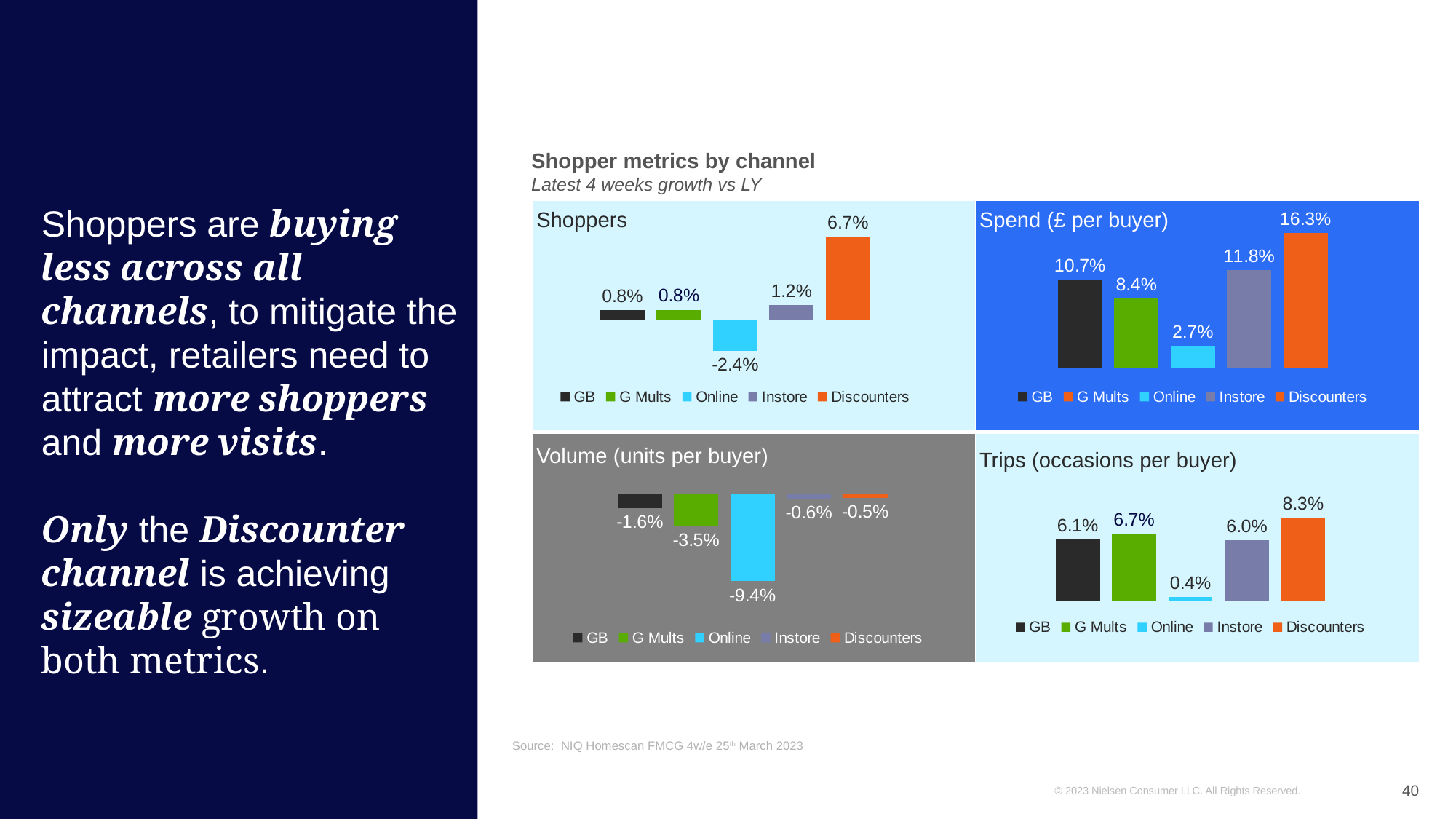
What is the subtitle shown under the heading 'Shopper metrics by channel'? Latest 4 weeks growth vs LY What kind of chart is the Volume (units per buyer) chart? Bar chart In the Shoppers chart, what is the value for Online? -2.4% In the Spend (£ per buyer) chart, what is the difference between Discounters and GB? 5.6% In the Spend (£ per buyer) chart, what is the value for Instore? 11.8% In the Trips (occasions per buyer) chart, what is the value for Online? 0.4% In the Volume (units per buyer) chart, what is the value for G Mults? -3.5% In the Shoppers chart, what is the value for Discounters? 6.7% In the Trips (occasions per buyer) chart, which is larger, Discounters or G Mults? Discounters In the Spend (£ per buyer) chart, which channel has the highest value? Discounters In the Volume (units per buyer) chart, which channel has the lowest value? Online How many series does the legend of the Shoppers chart list? 5